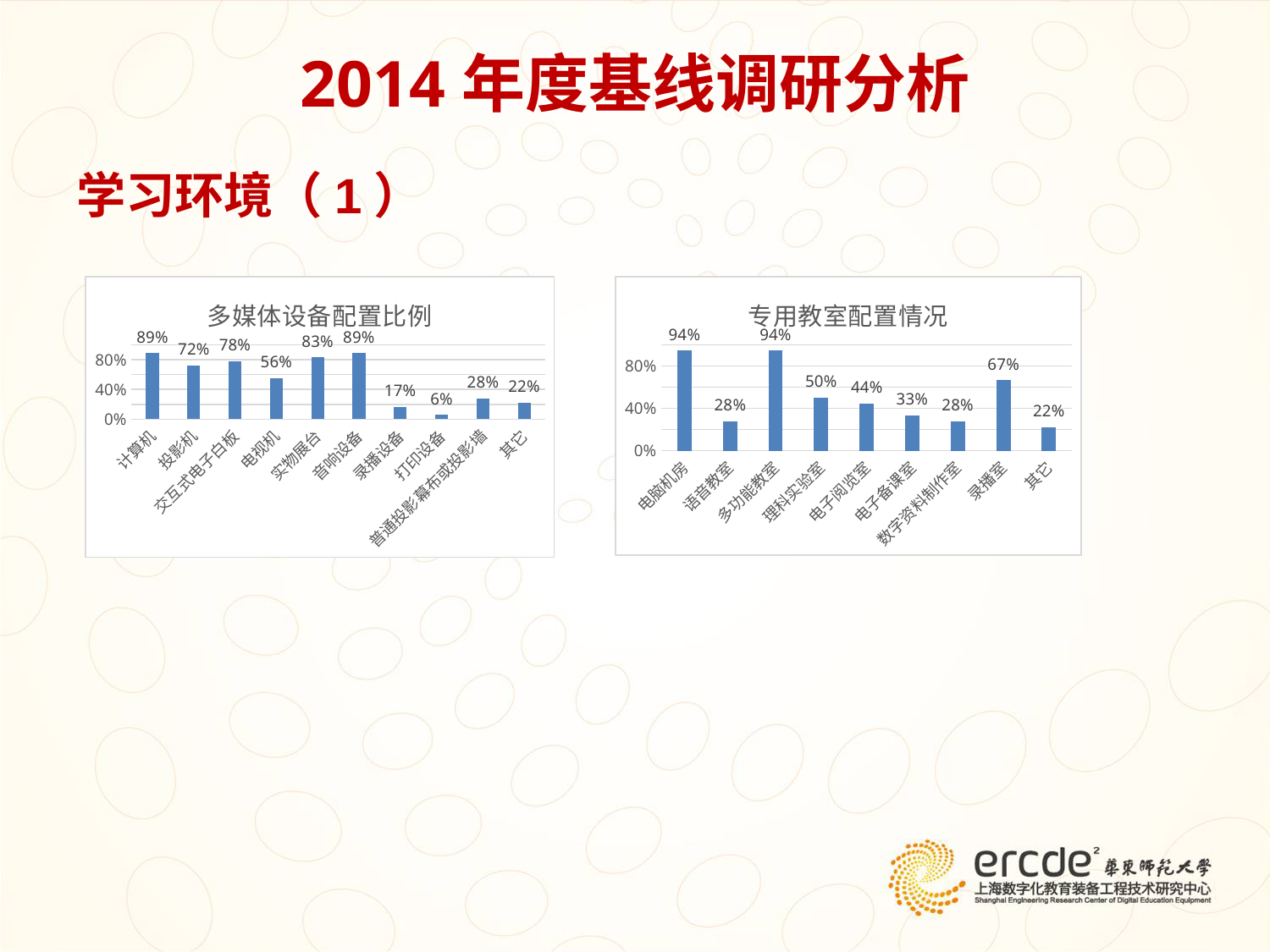
What type of chart is the chart titled 专用教室配置情况? bar chart In the chart titled 专用教室配置情况, what is the value for 录播室? 67% How many categories are shown in the chart titled 多媒体设备配置比例? 10 In the chart titled 专用教室配置情况, what is the difference between the values for 电脑机房 and 语音教室? 66% In the chart titled 多媒体设备配置比例, what is the difference between the values for 实物展台 and 投影机? 11% In the chart titled 多媒体设备配置比例, which is larger, the value for 交互式电子白板 or the value for 电视机? 交互式电子白板 In the chart titled 专用教室配置情况, what is the value for 理科实验室? 50% In the chart titled 专用教室配置情况, which category has the lowest value? 其它 In the chart titled 多媒体设备配置比例, what is the value for 录播设备? 17% In the chart titled 多媒体设备配置比例, which category has the lowest value? 打印设备 How many categories are shown in the chart titled 专用教室配置情况? 9 In the chart titled 多媒体设备配置比例, what is the value for 电视机? 56%